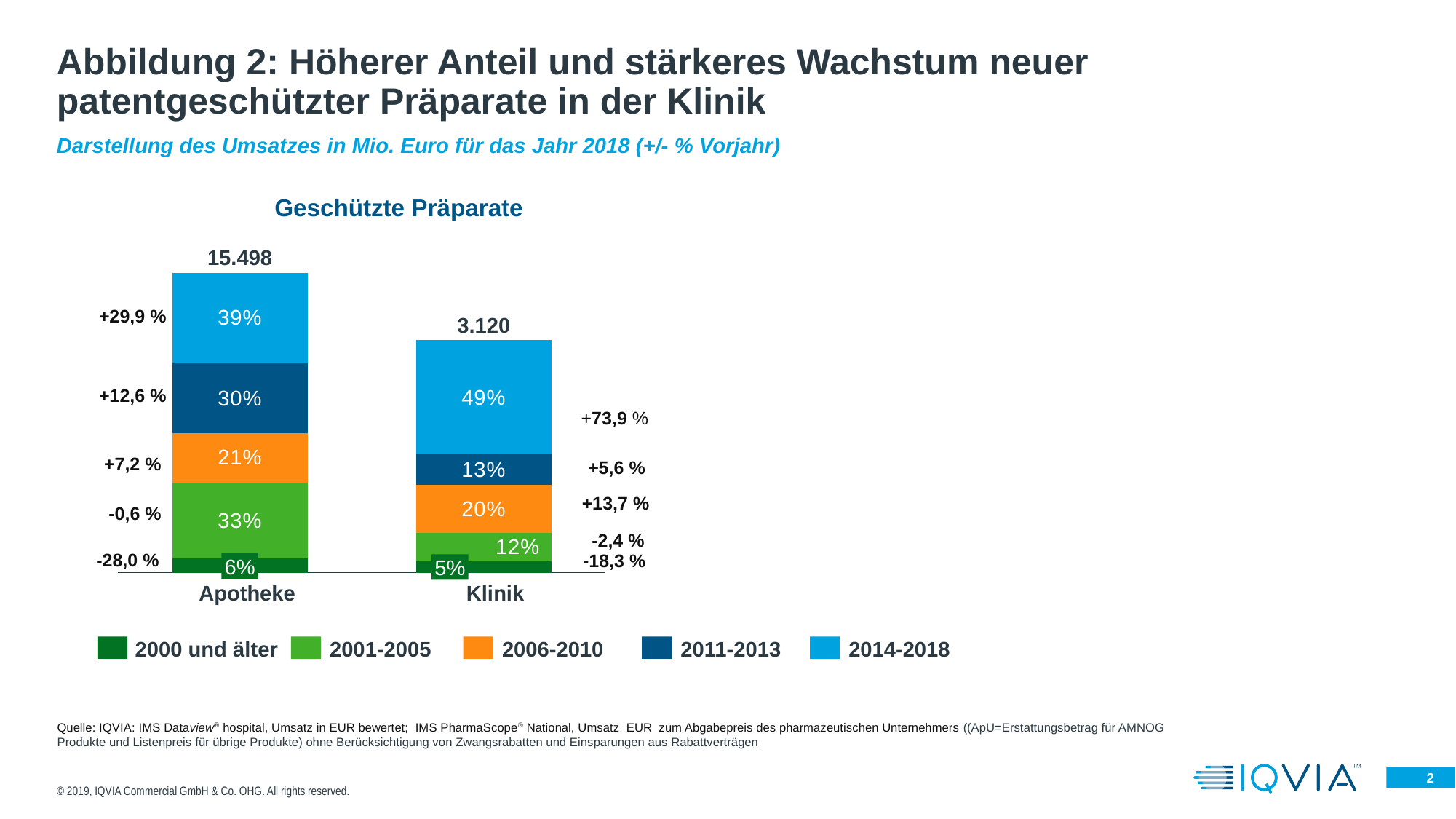
Which segment has the largest share within the Klinik bar? 2014-2018 Which category has the higher total, Apotheke or Klinik? Apotheke How many categories are shown on the x axis? 2 What kind of chart is shown on the slide? stacked bar chart What is the total value shown above the Apotheke bar? 15.498 What share of the Klinik bar is labelled for the 2000 und älter segment? 5% How many series does the legend list? 5 What share of the Klinik bar is labelled for the 2014-2018 segment? 49% What is the title of the chart? Geschützte Präparate What share of the Apotheke bar is labelled for the 2001-2005 segment? 33% What share of the Apotheke bar is labelled for the 2011-2013 segment? 30% What is the total value shown above the Klinik bar? 3.120